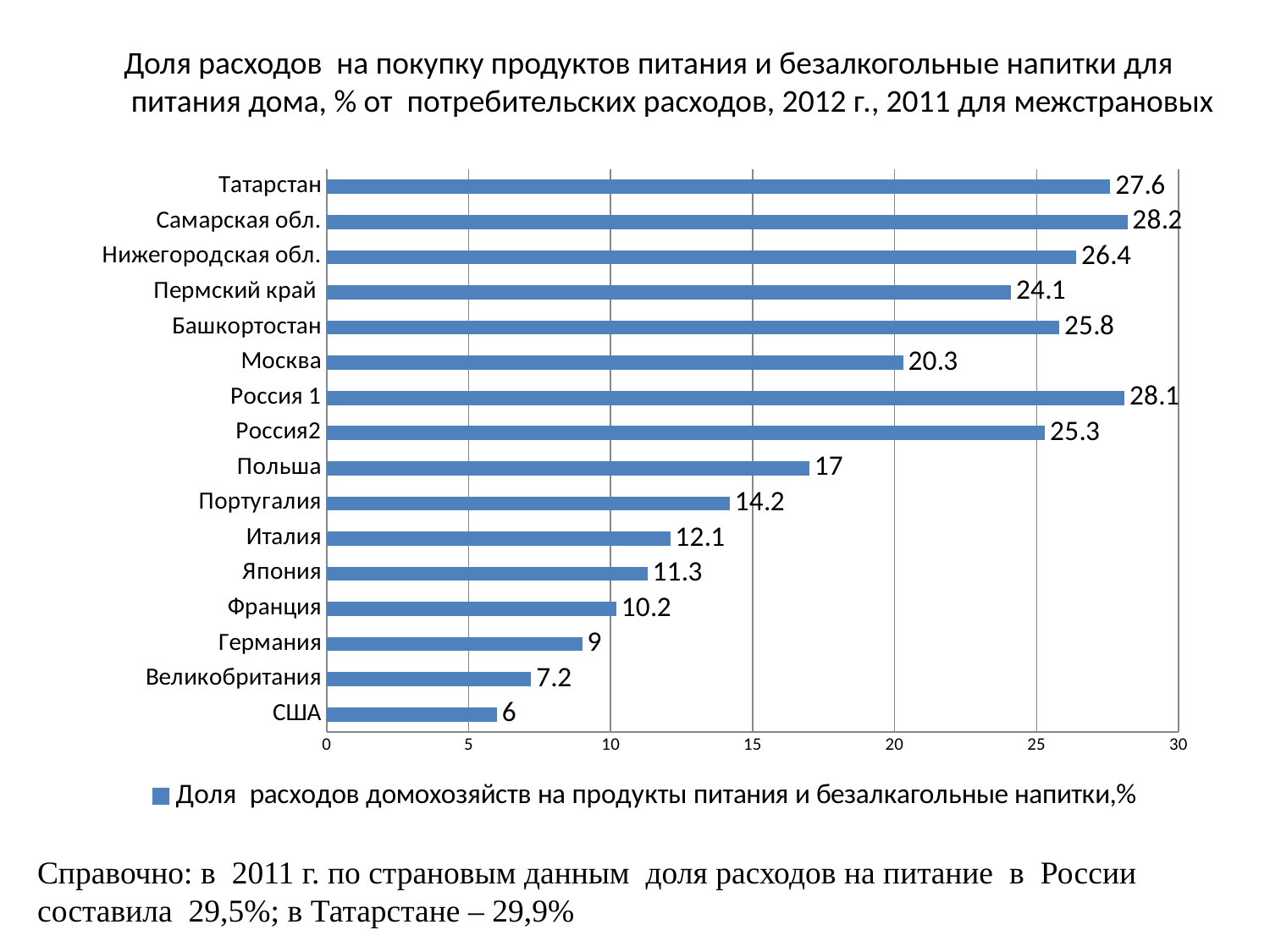
How many categories are shown in the chart? 16 What kind of chart is shown on the slide? bar chart Which category has the lowest value? США Which is larger, the value for Пермский край or the value for Башкортостан? Башкортостан What is the value for Португалия? 14.2 What is the value for Татарстан? 27.6 How many series does the legend list? 1 What is the difference between the values for Татарстан and США? 21.6 What is the value for Германия? 9 What is the value for Москва? 20.3 What is the difference between the values for Россия2 and Польша? 8.3 Is the value for Япония greater or less than 10? greater